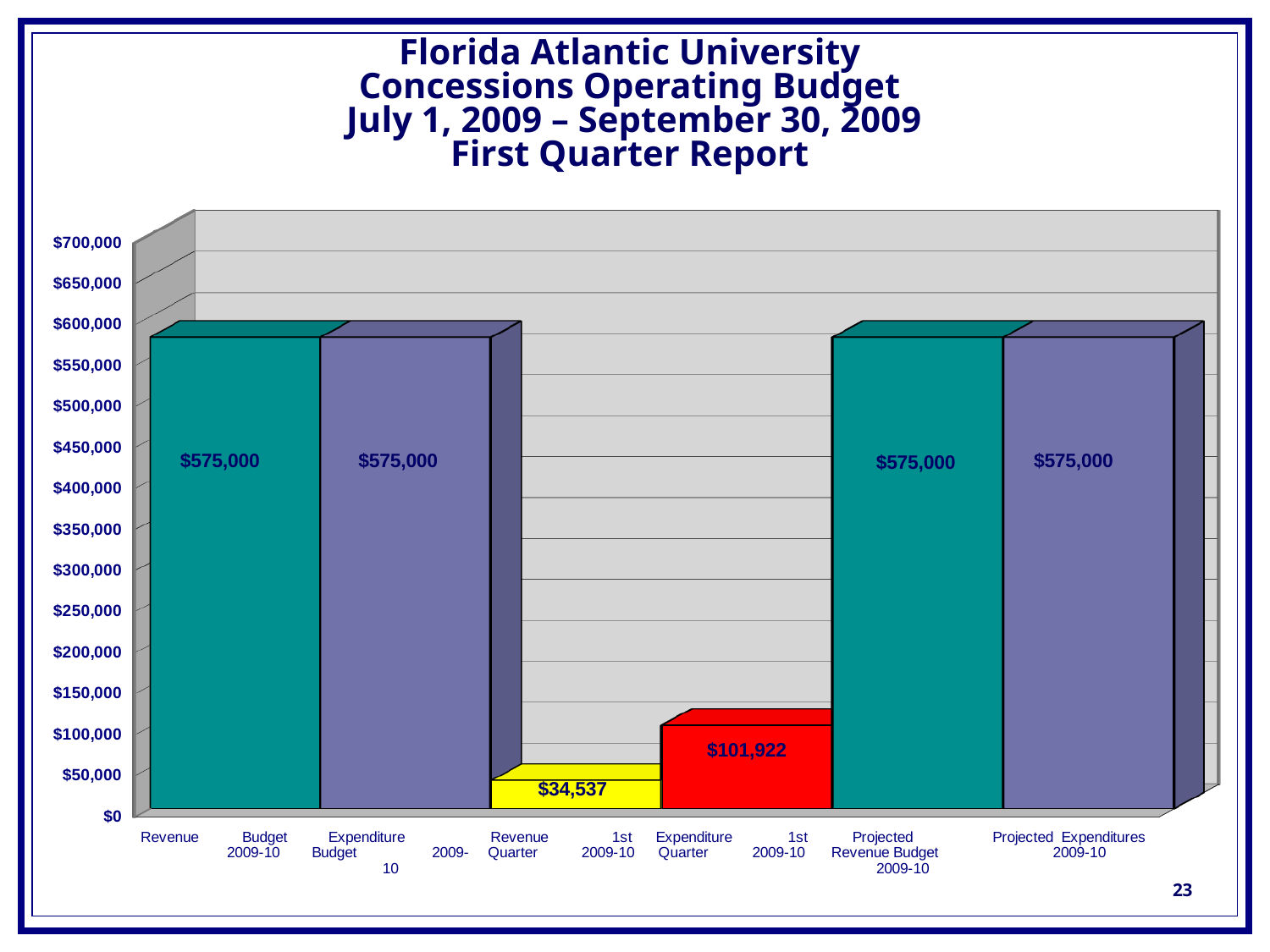
What is the value for Revenue 1st Quarter 2009-10? $34,537 What is the value for Projected Expenditures 2009-10? $575,000 How many bars are plotted in the chart? 6 What is the value for Revenue Budget 2009-10? $575,000 What is the value for Expenditure 1st Quarter 2009-10? $101,922 What kind of chart is shown on the slide? Bar chart What is the difference between Revenue Budget 2009-10 and Revenue 1st Quarter 2009-10? $540,463 Is the value for Expenditure 1st Quarter 2009-10 greater or less than $150,000? less Which is larger, Revenue 1st Quarter 2009-10 or Expenditure 1st Quarter 2009-10? Expenditure 1st Quarter 2009-10 What is the difference between Expenditure 1st Quarter 2009-10 and Revenue 1st Quarter 2009-10? $67,385 What colour is the bar for Expenditure 1st Quarter 2009-10? Red Which category has the lowest value? Revenue 1st Quarter 2009-10